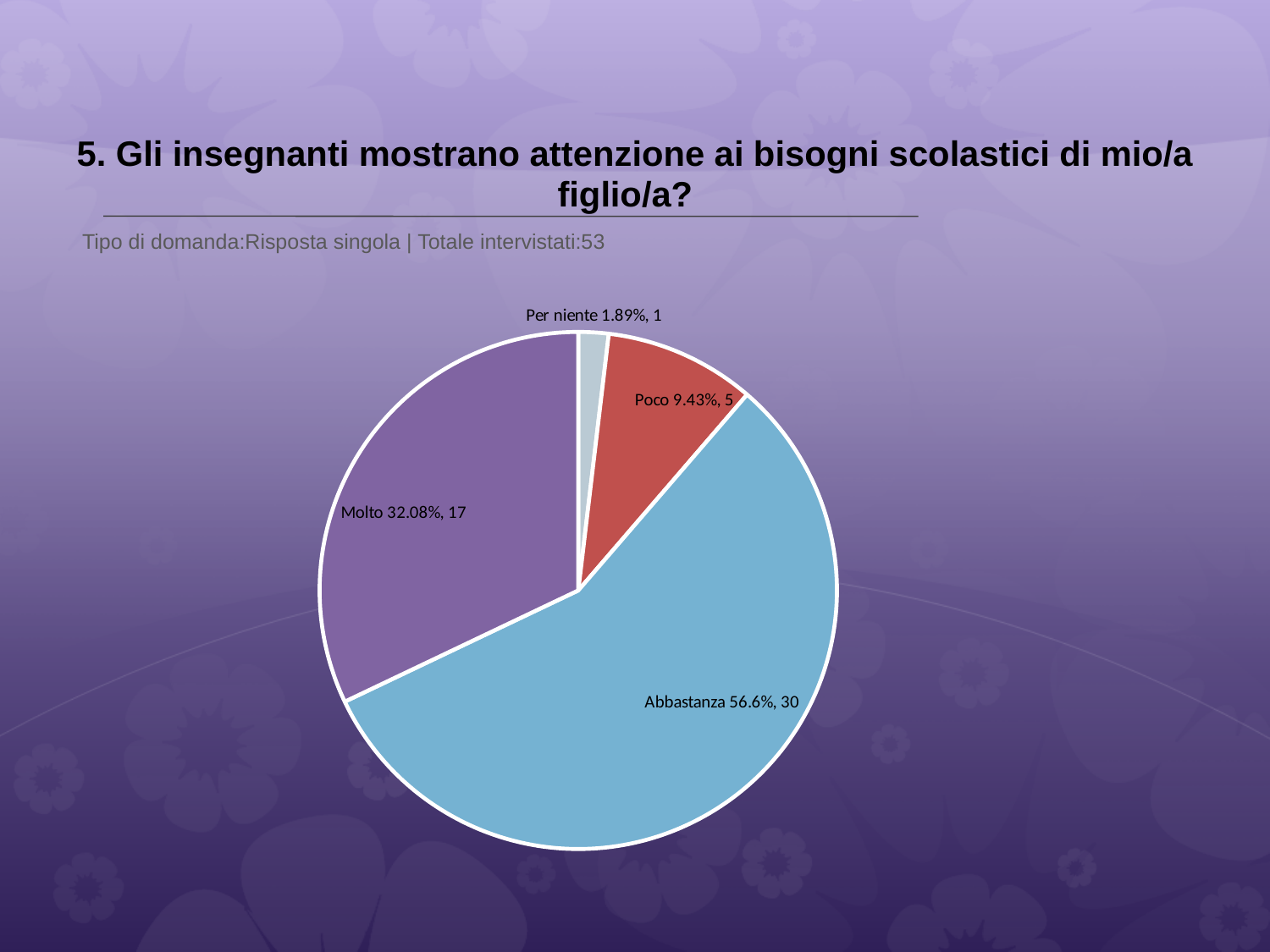
How many respondents answered "Per niente"? 1 How many slices does the pie chart have? 4 Which response category has the smallest share of the pie? Per niente Which response category has the largest share of the pie? Abbastanza What percentage of respondents answered "Abbastanza"? 56.6% What colour is the "Abbastanza" slice? light blue What percentage of respondents answered "Poco"? 9.43% What kind of chart is shown on the slide? pie chart What is the total number of respondents stated on the slide? 53 What is the difference in the number of respondents between "Abbastanza" and "Molto"? 13 How many respondents answered "Molto"? 17 Which has more respondents, "Poco" or "Molto"? Molto